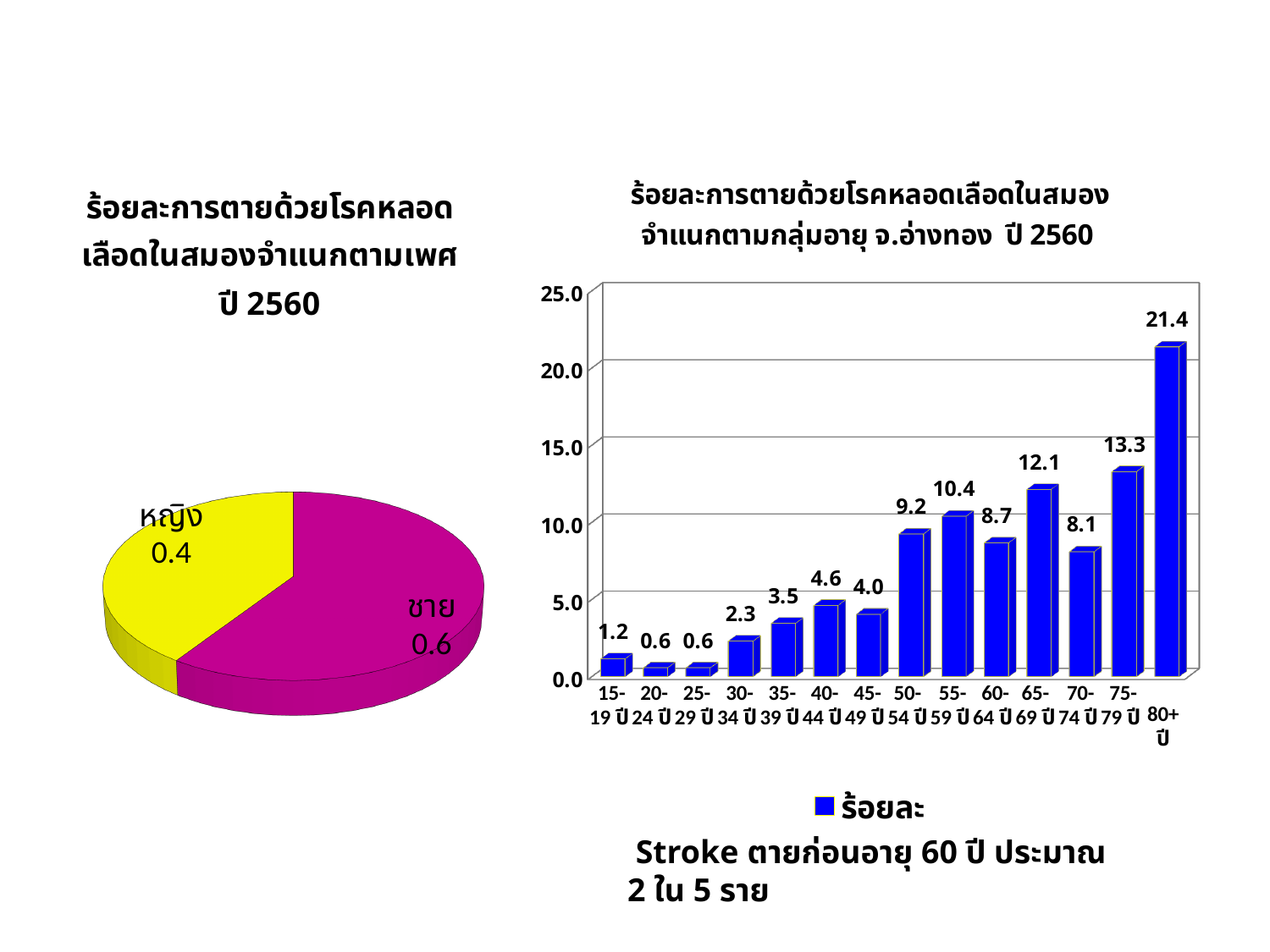
In the bar chart on the right, which is larger, the value for 50-54 ปี or the value for 60-64 ปี? 50-54 ปี In the bar chart on the right, what is the value for the 80+ ปี age group? 21.4 In the bar chart on the right, is the value for 65-69 ปี greater or less than 10.0? greater What kind of chart is the chart on the left of the slide? pie chart In the bar chart on the right, what is the difference between the values for 75-79 ปี and 70-74 ปี? 5.2 In the bar chart on the right, what is the value for the 55-59 ปี age group? 10.4 What kind of chart is the chart on the right of the slide? bar chart How many series does the legend of the bar chart on the right list? 1 How many age groups are shown in the bar chart on the right? 14 In the bar chart on the right, which age group has the highest value? 80+ ปี In the pie chart on the left, what is the value for ชาย? 0.6 In the pie chart on the left, which slice is larger, ชาย or หญิง? ชาย